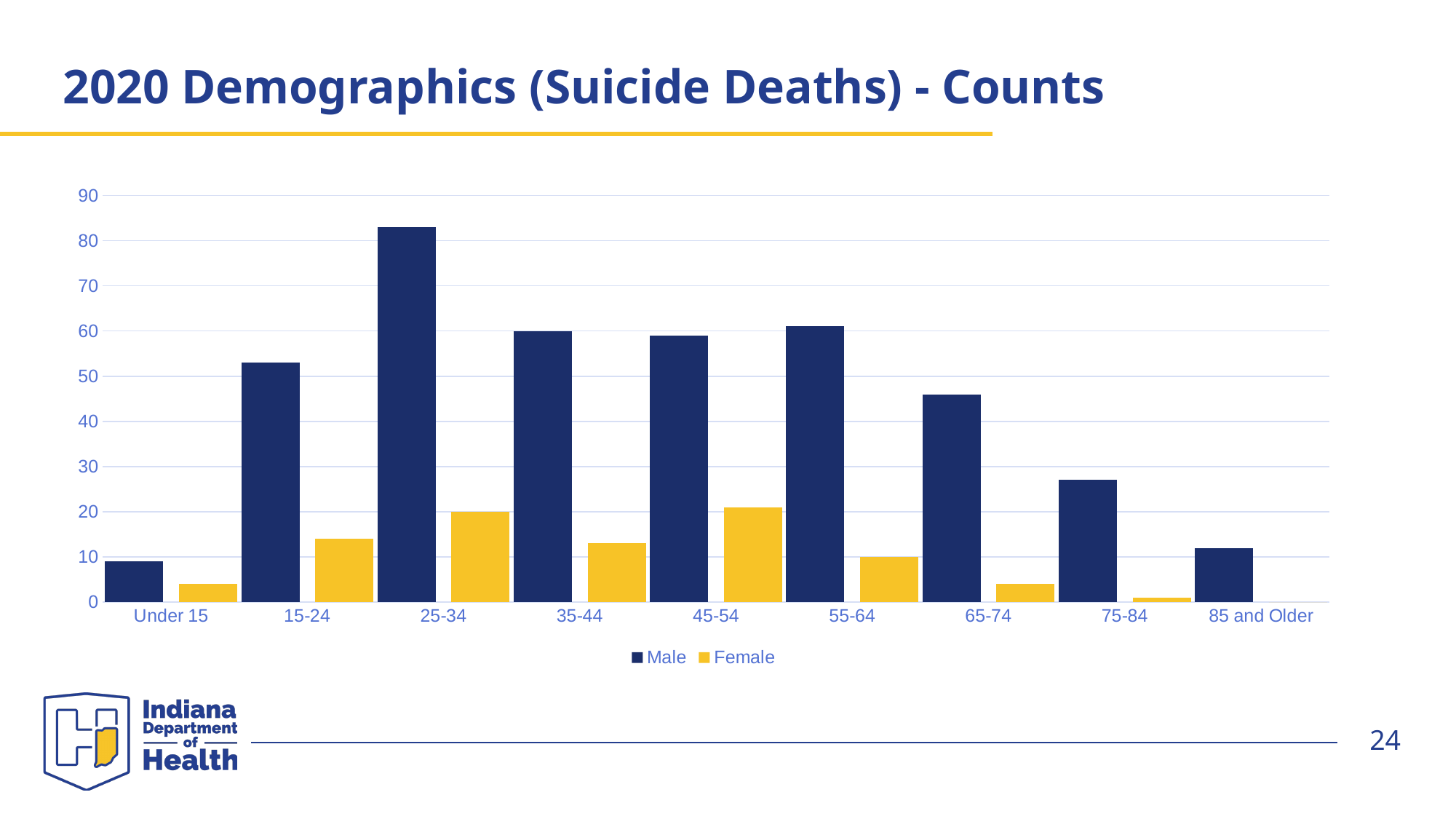
Which is larger, the Male count for 15-24 or the Male count for 65-74? 15-24 What kind of chart is shown on the slide? bar chart Which age group has the highest Male count? 25-34 Which age group has the lowest Male count? Under 15 How many series does the legend list? 2 What is the title of the chart on the slide? 2020 Demographics (Suicide Deaths) - Counts Is the Male value for 65-74 greater or less than 50? less Is the Male value for 25-34 greater or less than 80? greater Is the Female value for 75-84 greater or less than 10? less How many age categories are shown on the x axis? 9 Which is larger, the Female count for 15-24 or the Female count for 65-74? 15-24